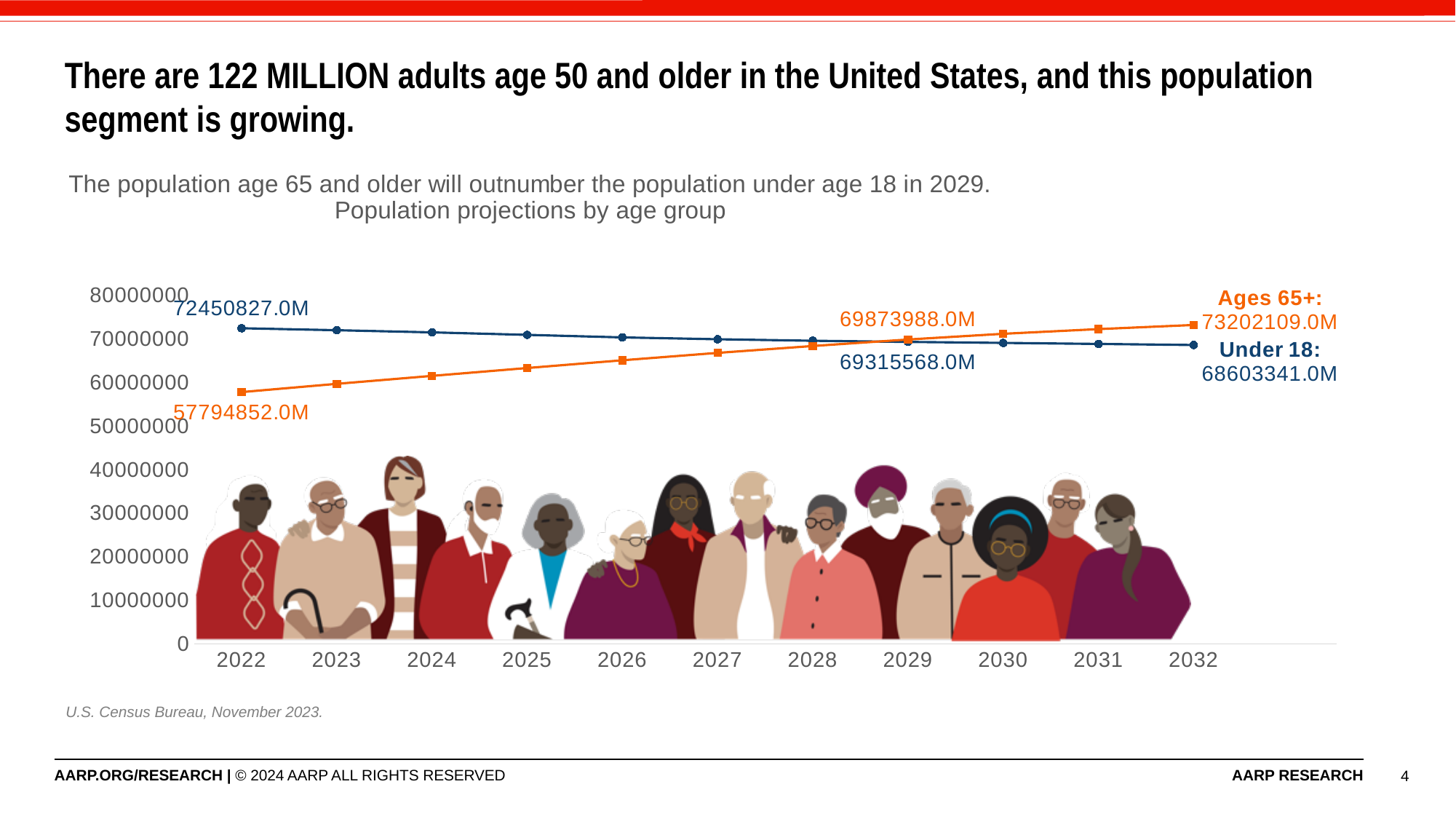
What is the value for Ages 65+ in 2032? 73202109.0M Does the Ages 65+ series rise or fall from 2022 to 2032? rise What is the title of the chart? Population projections by age group Is the value for Ages 65+ in 2024 greater or less than 60000000? greater What is the value for Under 18 in 2022? 72450827.0M What is the value for Under 18 in 2029? 69315568.0M What is the difference between the Under 18 and Ages 65+ values in 2022? 14655975.0M How many years are shown along the x axis of the chart? 11 How many series are plotted in the chart? 2 What type of chart is shown on the slide? line chart In 2029, which series has the larger value, Ages 65+ or Under 18? Ages 65+ What is the value for Ages 65+ in 2022? 57794852.0M